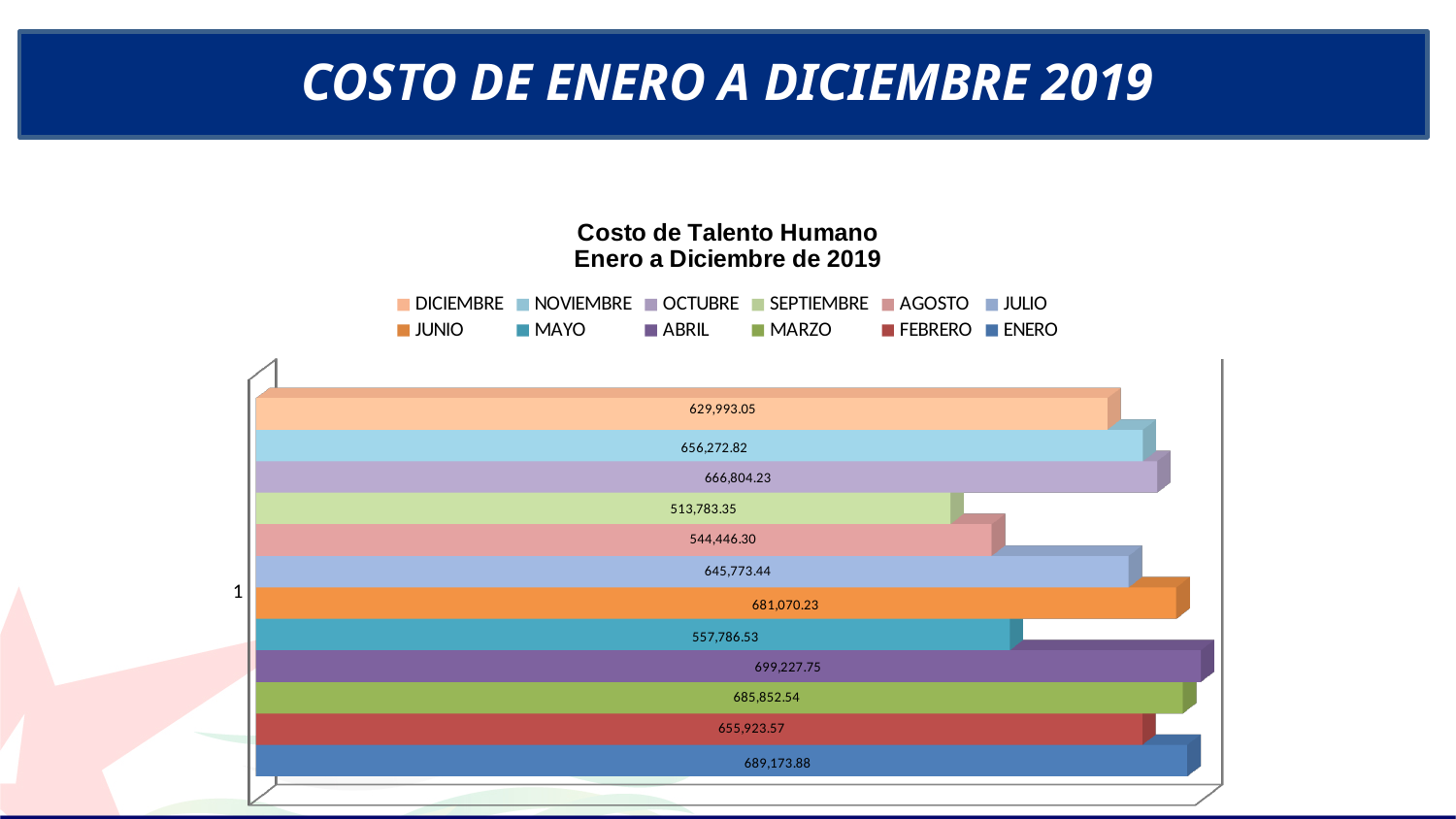
What is the difference between the values for ABRIL and SEPTIEMBRE? 185,444.40 What kind of chart is shown on the slide? Bar chart Which month has the lowest value in the chart? SEPTIEMBRE Which month has the highest value in the chart? ABRIL What is the value for SEPTIEMBRE in the chart? 513,783.35 What is the value for DICIEMBRE in the chart? 629,993.05 What is the difference between the values for JUNIO and MAYO? 123,283.70 How many series does the legend list? 12 What is the value for ENERO in the chart? 689,173.88 What is the title of the chart? Costo de Talento Humano Enero a Diciembre de 2019 Which is larger, the value for JULIO or the value for AGOSTO? JULIO What is the value for ABRIL in the Costo de Talento Humano chart? 699,227.75